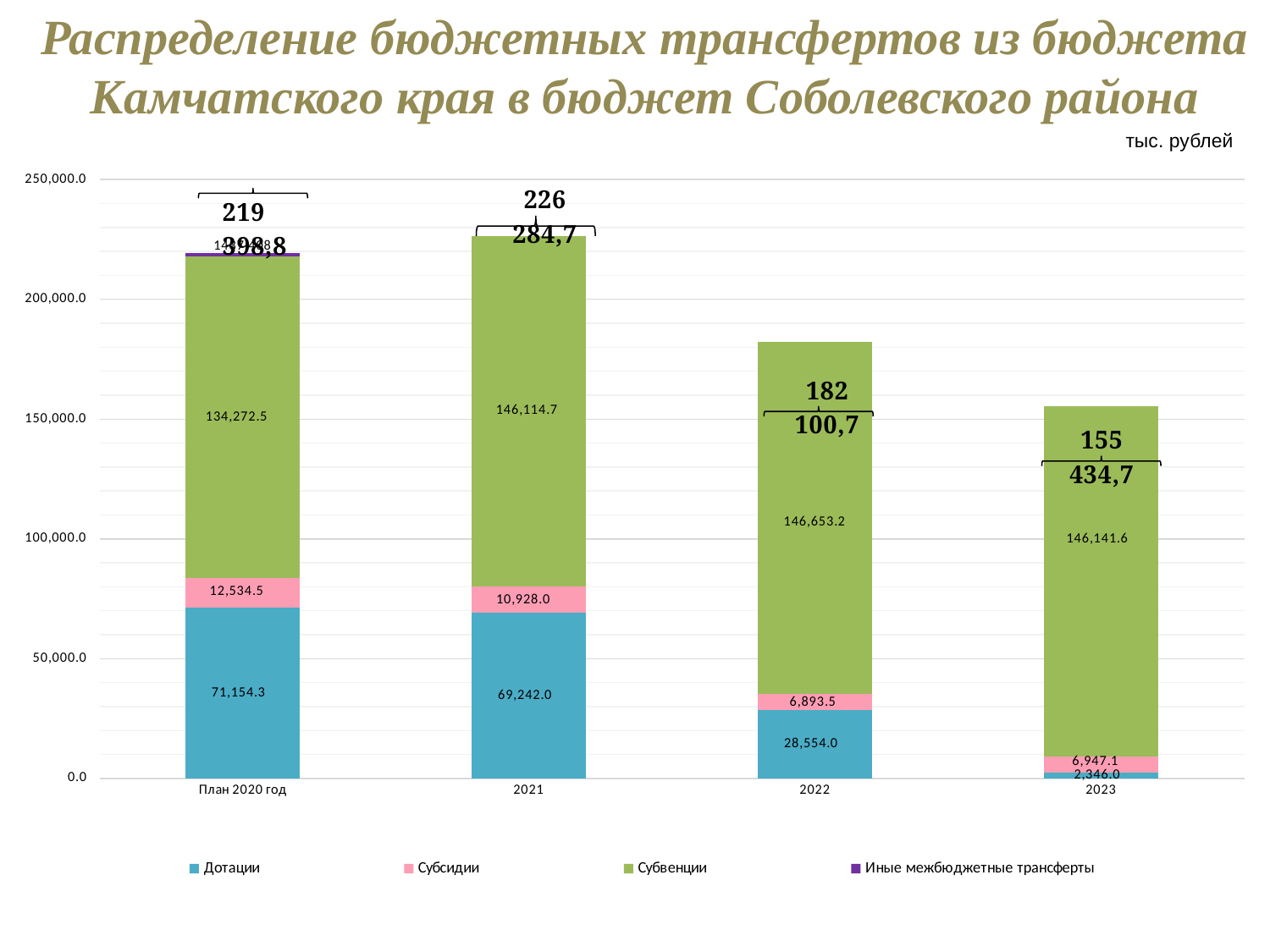
What is the value of Субсидии for 2023? 6,947.1 In which category is the value of Дотации the lowest? 2023 What is the value of Дотации for 2021? 69,242.0 What is the value of Субвенции for 2022? 146,653.2 Do the total bar heights rise or fall from План 2020 год to 2023? fall What kind of chart is shown on the slide? stacked bar chart In which category is the value of Субсидии the highest? План 2020 год What is the total of the stacked bar for 2022? 182 100,7 What is the difference between the Дотации values for 2021 and 2022? 40,688.0 How many series does the legend list? 4 How many categories (years) are shown on the x axis? 4 Is the value of Дотации for 2022 greater or less than 50,000.0? less